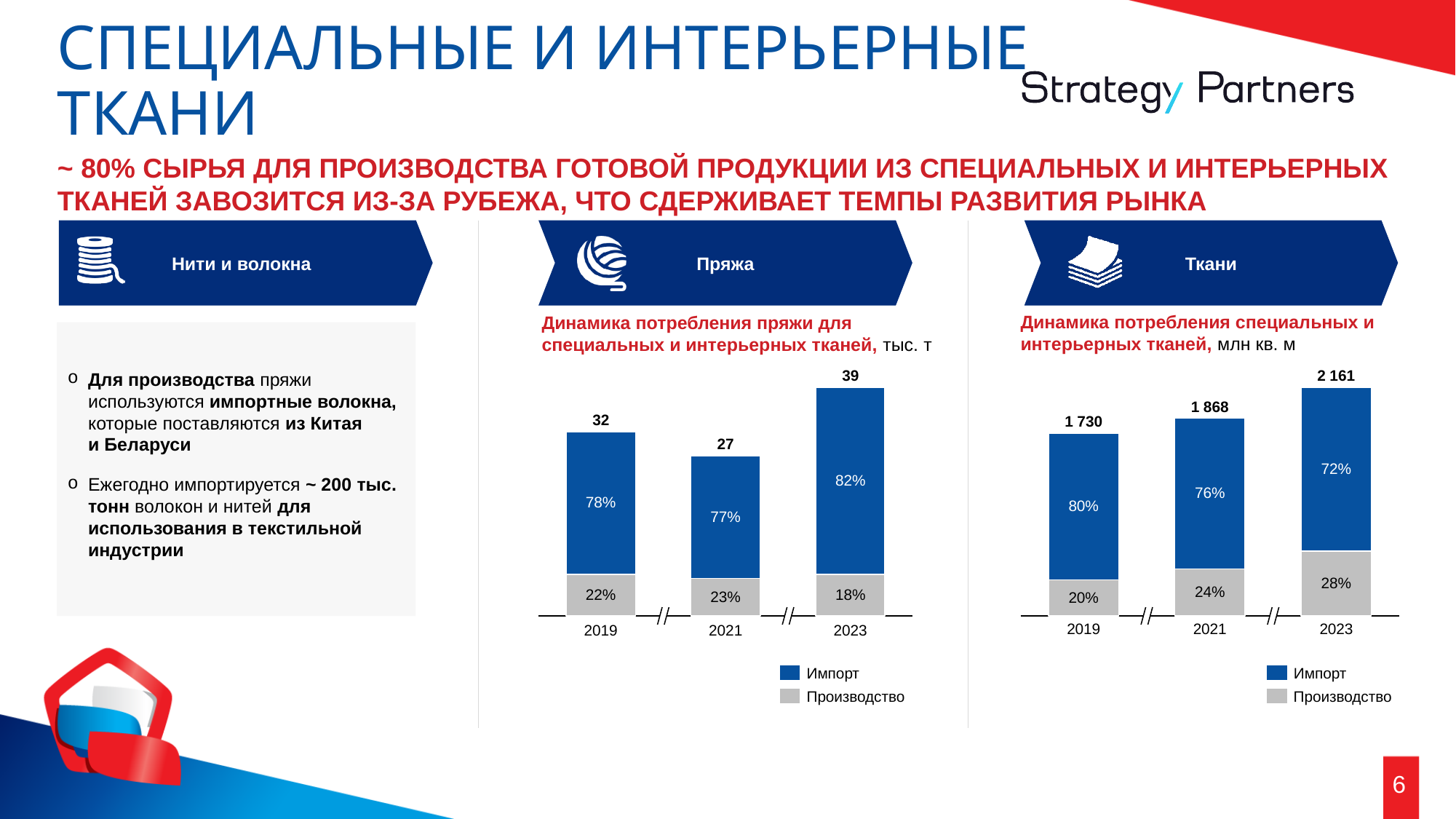
On the chart 'Динамика потребления пряжи для специальных и интерьерных тканей', what is the difference between the totals for 2023 and 2019? 7 On the chart 'Динамика потребления специальных и интерьерных тканей', how does the total change from 2019 to 2023? It rises On the chart 'Динамика потребления специальных и интерьерных тканей', what share does Производство have in 2023? 28% On the chart 'Динамика потребления специальных и интерьерных тканей', is the Импорт share larger in 2019 or in 2023? 2019 On the chart 'Динамика потребления специальных и интерьерных тканей', what is the total value for 2021? 1 868 On the chart 'Динамика потребления пряжи для специальных и интерьерных тканей', which year has the lowest total? 2021 On the chart 'Динамика потребления пряжи для специальных и интерьерных тканей', what is the total value for 2023? 39 What unit is given in the title of the chart 'Динамика потребления специальных и интерьерных тканей'? млн кв. м On the chart 'Динамика потребления пряжи для специальных и интерьерных тканей', what share does Импорт have in 2021? 77% How many series does the legend of the chart 'Динамика потребления пряжи для специальных и интерьерных тканей' list? 2 On the chart 'Динамика потребления специальных и интерьерных тканей', which year has the highest total? 2023 What kind of chart is 'Динамика потребления специальных и интерьерных тканей'? Stacked bar chart